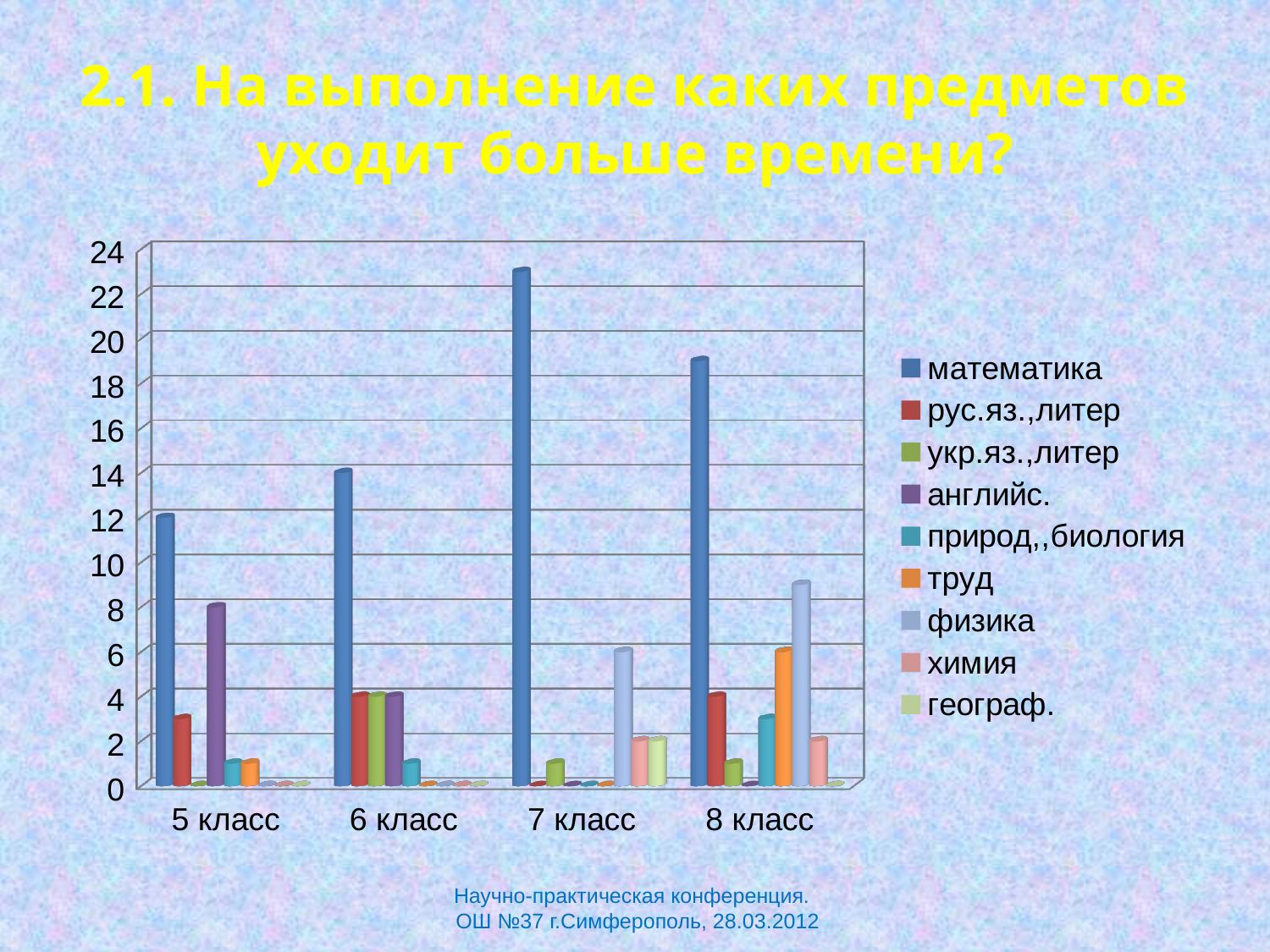
Is the value for английс. in 5 класс greater or less than 6? greater Is the value for физика in 8 класс greater or less than 10? less What kind of chart is shown on the slide? bar chart Which class has the shortest bar for математика? 5 класс Which class has the tallest bar for математика? 7 класс How many class categories are shown on the x axis? 4 Which is larger: the математика value for 7 класс or for 8 класс? 7 класс How many series does the legend list? 9 Is the value for математика in 7 класс greater or less than 20? greater Which series is listed first in the legend? математика Does the математика value rise or fall from 5 класс to 7 класс? rises